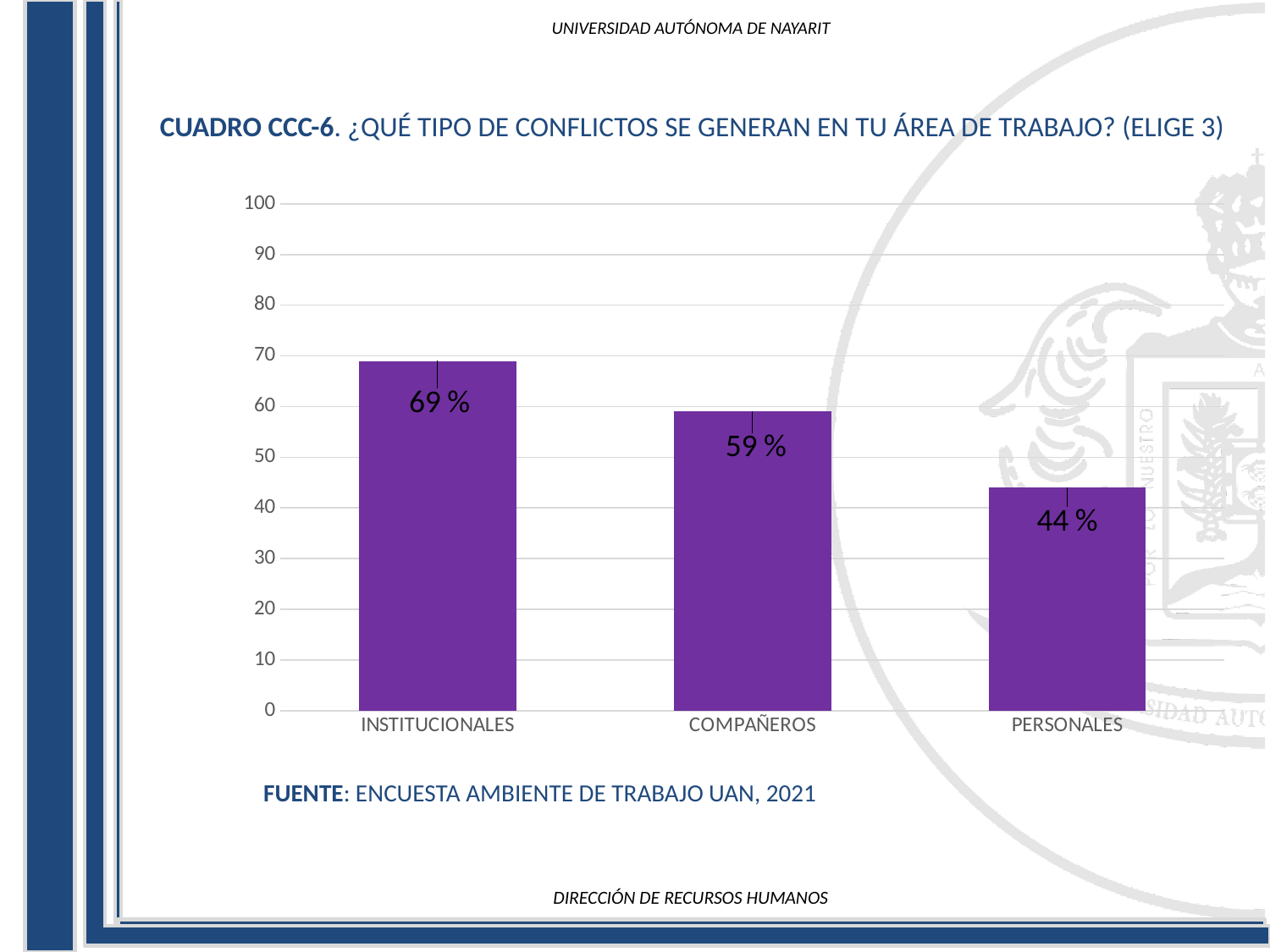
Is the value for COMPAÑEROS greater or less than 50? greater What is the difference between the values for COMPAÑEROS and PERSONALES? 15 % What is the value for PERSONALES? 44 % Which is larger, the value for COMPAÑEROS or the value for PERSONALES? COMPAÑEROS Do the values rise or fall from left to right along the x axis? fall How many categories are shown on the x axis? 3 Which category has the lowest value? PERSONALES What is the value for COMPAÑEROS? 59 % What is the difference between the values for INSTITUCIONALES and PERSONALES? 25 % Which category has the highest value? INSTITUCIONALES What kind of chart is shown on the slide? bar chart What is the value for INSTITUCIONALES? 69 %